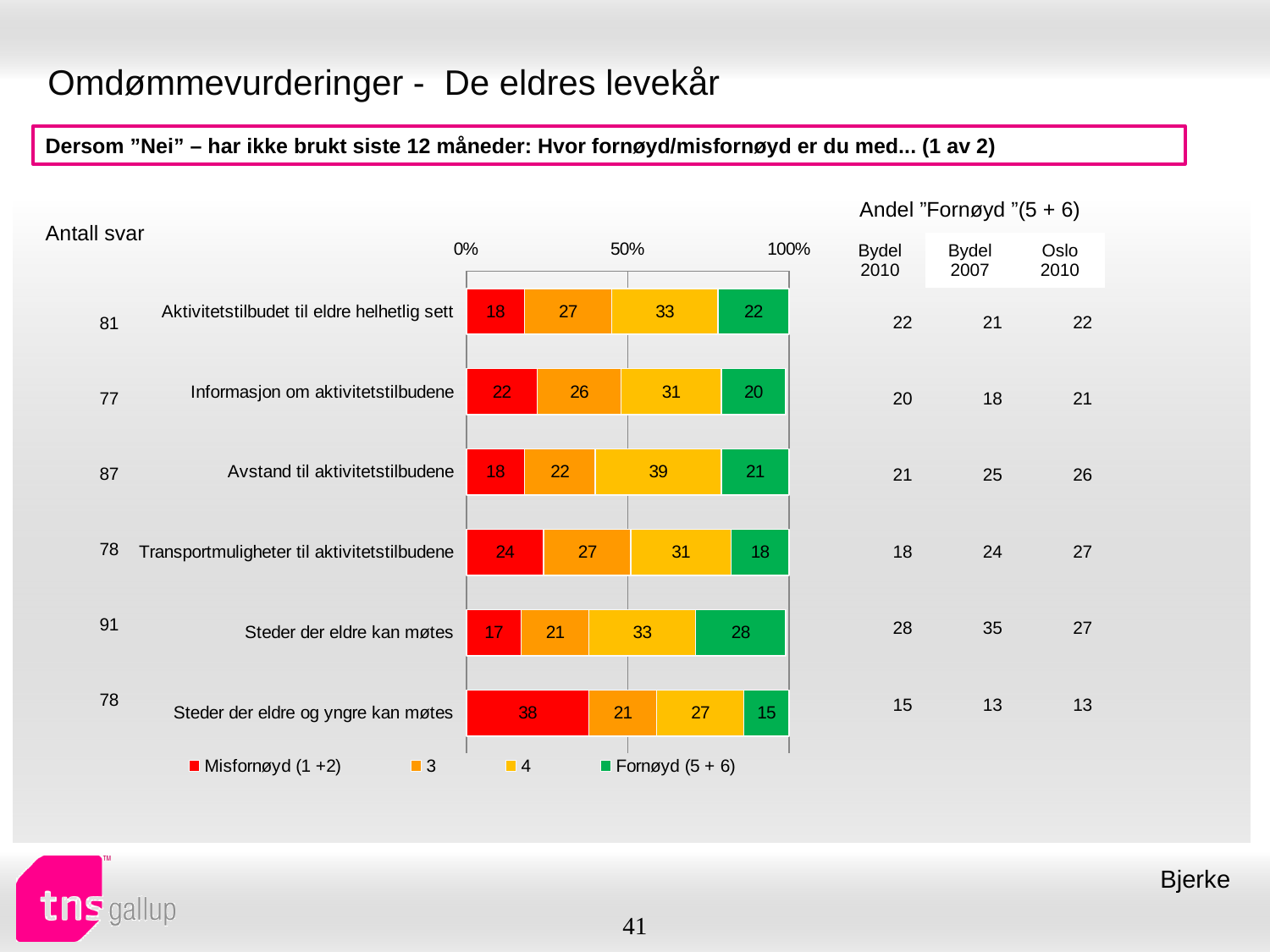
What is the value of 'Fornøyd (5 + 6)' for 'Steder der eldre kan møtes'? 28 What is the value of 'Misfornøyd (1 +2)' for 'Steder der eldre og yngre kan møtes'? 38 What is the total of the stacked bar for 'Aktivitetstilbudet til eldre helhetlig sett'? 100 How many categories are plotted in the chart? 6 Which category has the lowest value for 'Fornøyd (5 + 6)'? Steder der eldre og yngre kan møtes What kind of chart is shown on the slide? stacked bar chart Which category has the highest value for 'Misfornøyd (1 +2)'? Steder der eldre og yngre kan møtes Which is larger: the 'Fornøyd (5 + 6)' value for 'Aktivitetstilbudet til eldre helhetlig sett' or for 'Transportmuligheter til aktivitetstilbudene'? Aktivitetstilbudet til eldre helhetlig sett Which category has the highest value for 'Fornøyd (5 + 6)'? Steder der eldre kan møtes What is the value of series '4' for 'Avstand til aktivitetstilbudene'? 39 What is the difference between the 'Misfornøyd (1 +2)' values for 'Steder der eldre og yngre kan møtes' and 'Transportmuligheter til aktivitetstilbudene'? 14 How many series does the chart legend list? 4